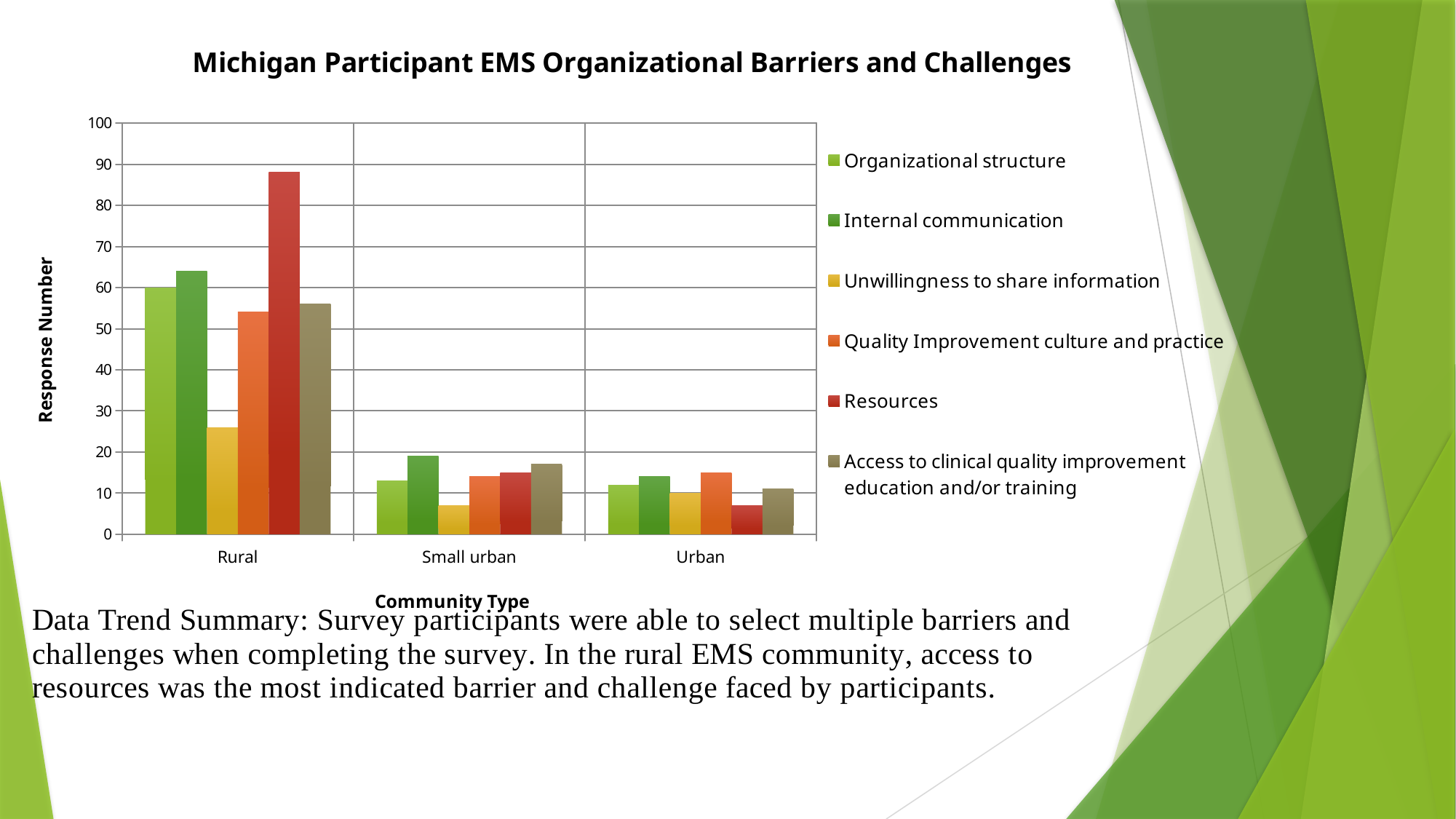
Which is larger for the Rural community: Internal communication or Organizational structure? Internal communication Which barrier has the lowest response number for the Rural community type? Unwillingness to share information Which is larger for the Urban community: Resources or Quality Improvement culture and practice? Quality Improvement culture and practice What type of chart is shown on the slide? bar chart What is the label of the y axis? Response Number Is the value for Unwillingness to share information in the Rural community greater or less than 30? less How many community types are shown on the x axis? 3 Is the value for Resources in the Rural community greater or less than 80? greater Which barrier has the highest response number for the Rural community type? Resources What is the title of the chart? Michigan Participant EMS Organizational Barriers and Challenges Is the value for Internal communication in the Small urban community greater or less than 10? greater How many series does the legend list? 6